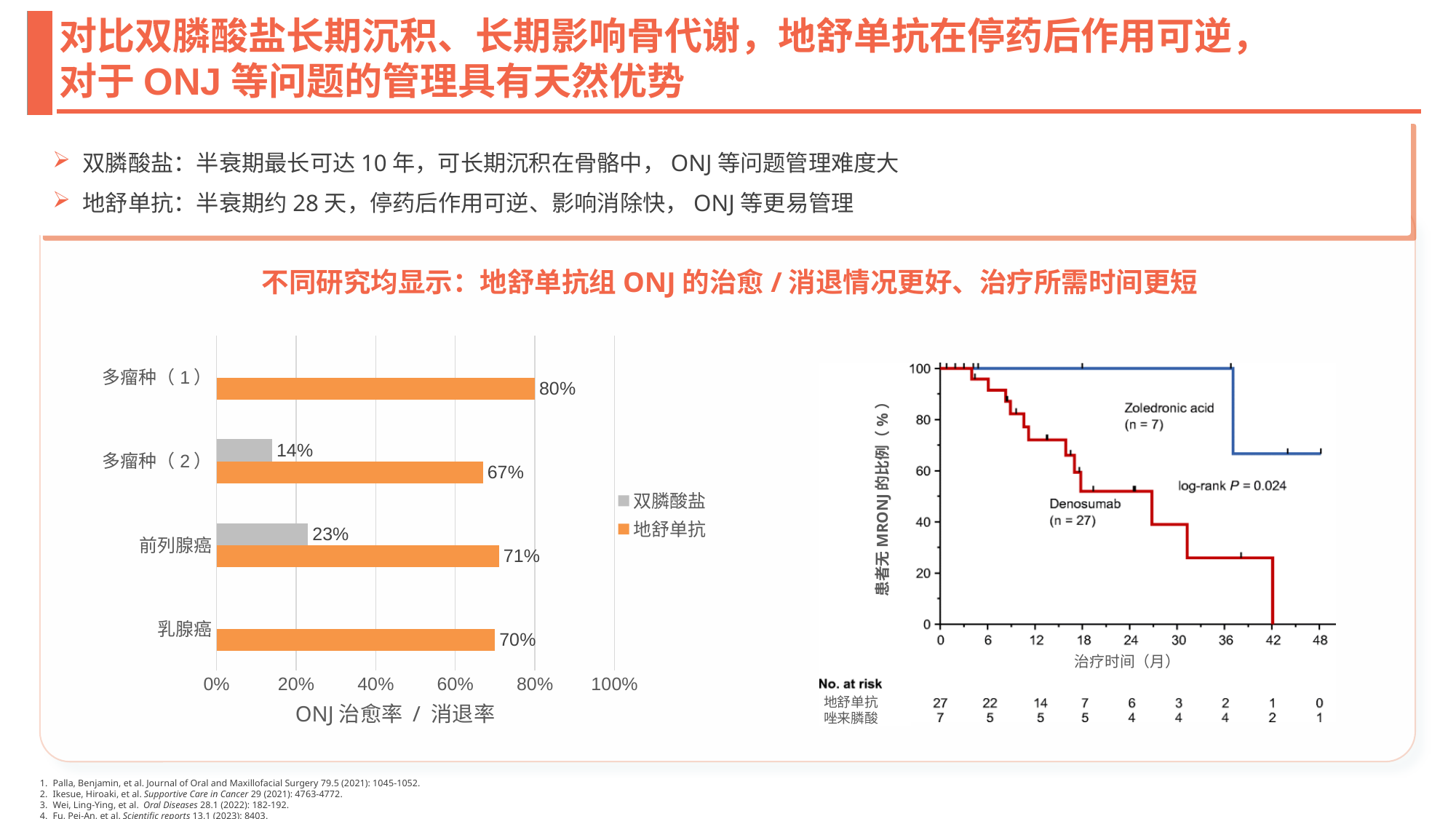
In the left bar chart, what is the difference between the 地舒单抗 and 双膦酸盐 values for 多瘤种（2）? 53% In the left bar chart, which colour represents 地舒单抗? Orange In the left bar chart, what is the 双膦酸盐 value for 前列腺癌? 23% In the left bar chart, which is larger for 前列腺癌: the 地舒单抗 value or the 双膦酸盐 value? 地舒单抗 How many series does the legend of the left bar chart list? 2 In the right chart, what is the log-rank P value shown? 0.024 In the right chart, how many patients are in the Denosumab group (n)? 27 In the left bar chart (ONJ 治愈率 / 消退率), what is the 地舒单抗 value for 多瘤种（1）? 80% How many categories are shown on the left bar chart? 4 What kind of chart is the chart on the left of the slide? Bar chart In the left bar chart, what is the 地舒单抗 value for 乳腺癌? 70% In the left bar chart, which category has the highest 地舒单抗 value? 多瘤种（1）